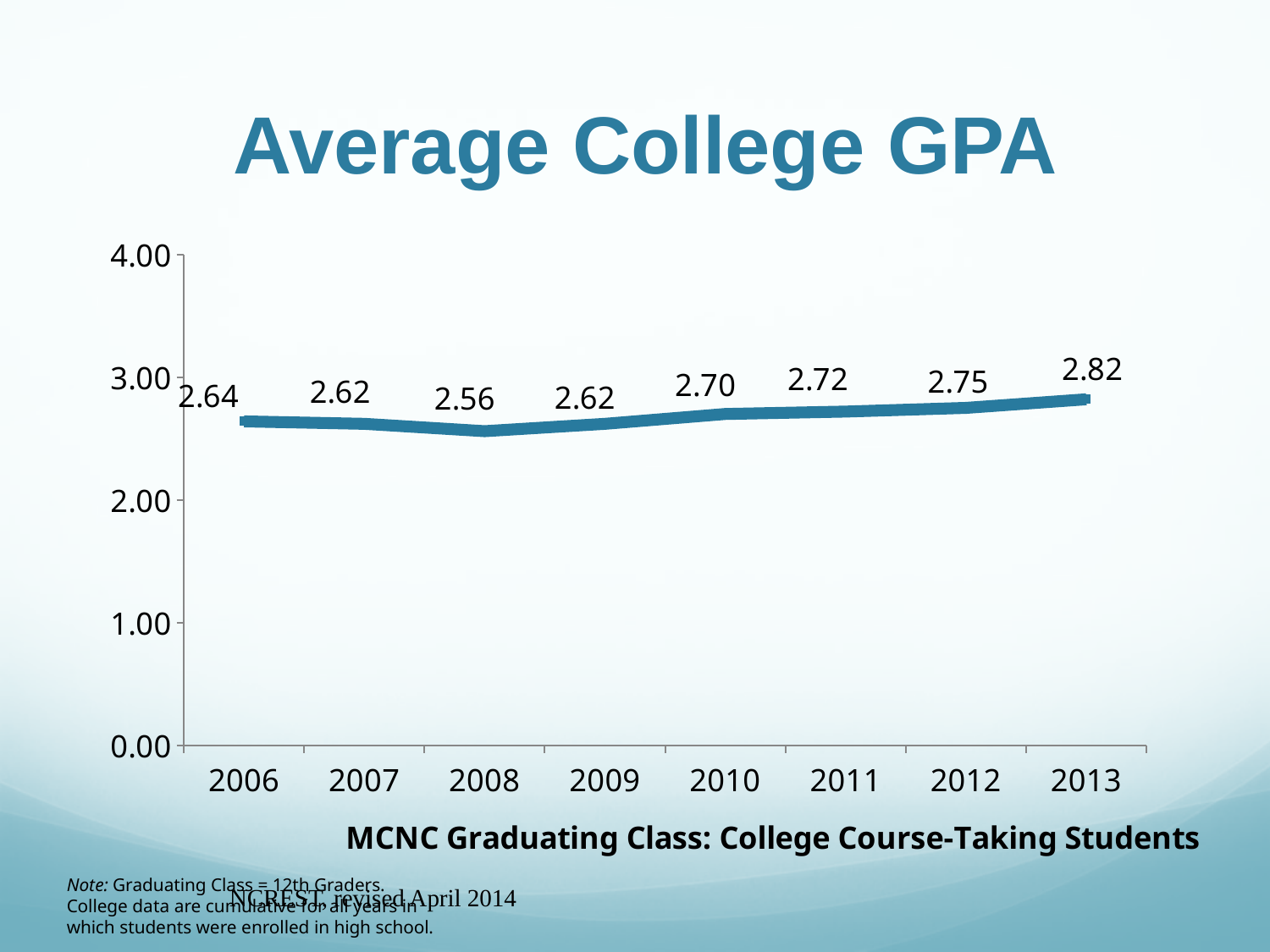
What is the average college GPA for the 2006 graduating class? 2.64 What is the difference in average college GPA between the 2013 and 2008 graduating classes? 0.26 How many graduating classes are plotted on the chart? 8 Does the average college GPA rise or fall from 2008 to 2013? rise What is the title of the chart? Average College GPA Which graduating class has the lowest average college GPA? 2008 Which graduating class has the highest average college GPA? 2013 What is the average college GPA for the 2013 graduating class? 2.82 What kind of chart is shown on the slide? line chart What is the average college GPA for the 2010 graduating class? 2.70 Which graduating class has a higher average college GPA, 2011 or 2006? 2011 Is the average college GPA for the 2012 graduating class greater or less than 3.00? less